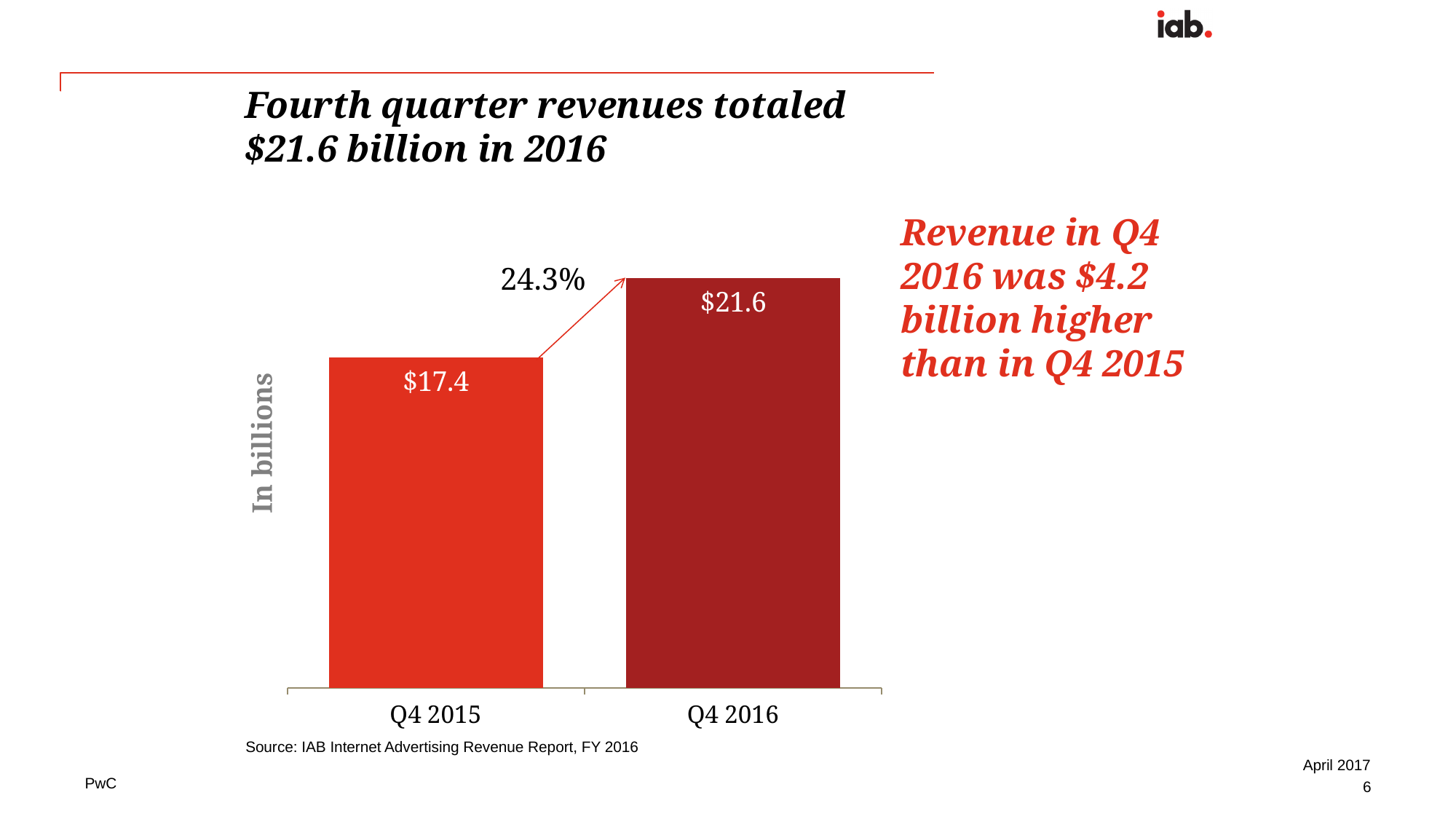
What is the value for Q4 2015? $17.4 What is the label on the vertical axis? In billions What percentage growth is labelled between the two bars? 24.3% What kind of chart is shown on the slide? bar chart Is the value for Q4 2016 larger or smaller than the value for Q4 2015? larger What is the difference between the Q4 2016 and Q4 2015 values? $4.2 What is the source cited below the chart? IAB Internet Advertising Revenue Report, FY 2016 What is the value for Q4 2016? $21.6 Which quarter has the lower revenue? Q4 2015 Do the values rise or fall from Q4 2015 to Q4 2016? rise How many bars are shown in the chart? 2 Which quarter has the higher revenue? Q4 2016